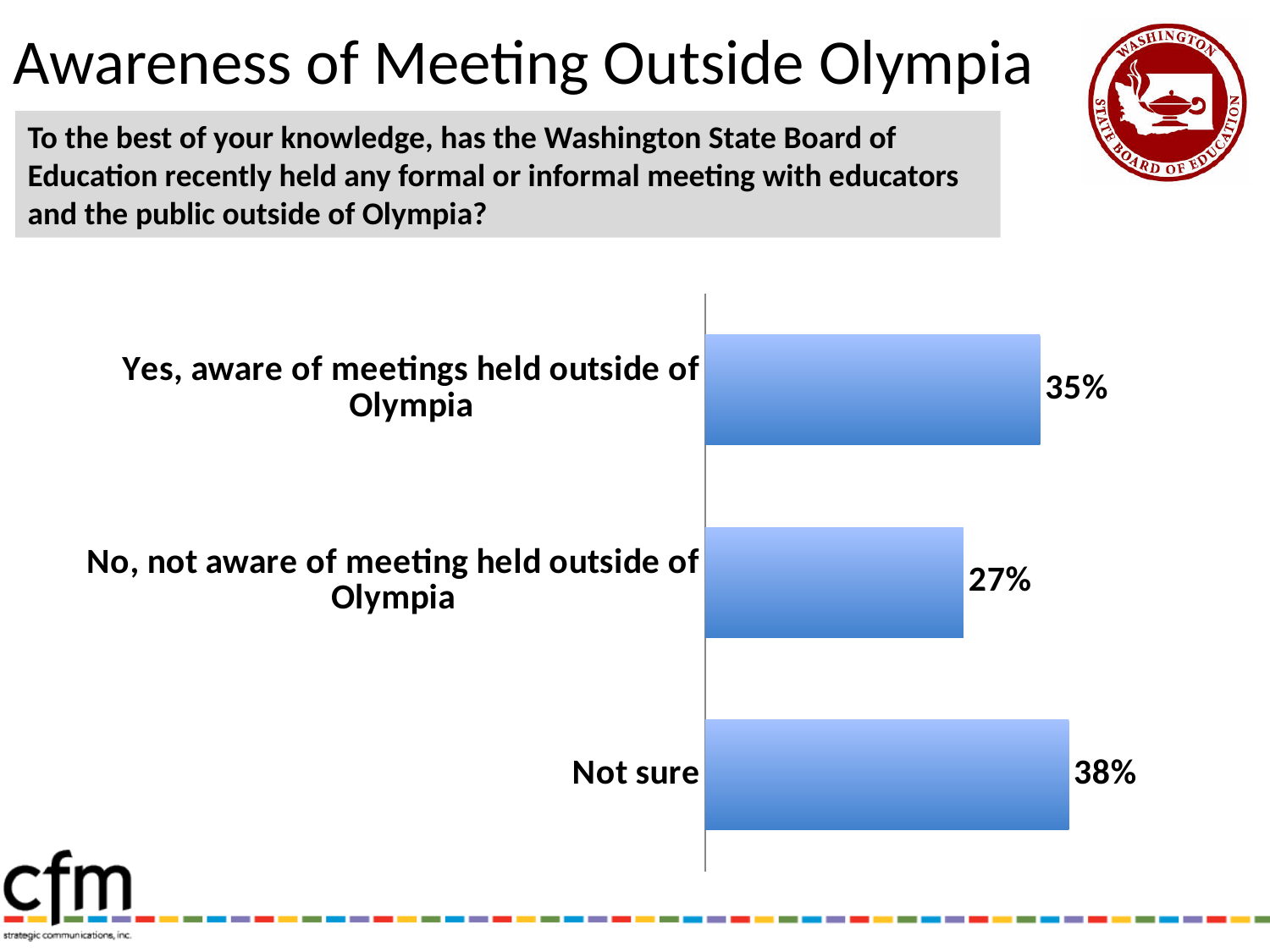
Which is larger: the percentage for "Yes, aware of meetings held outside of Olympia" or for "No, not aware of meeting held outside of Olympia"? Yes, aware of meetings held outside of Olympia Which response category has the highest percentage? Not sure Which response category has the lowest percentage? No, not aware of meeting held outside of Olympia What is the difference in percentage points between "Not sure" and "Yes, aware of meetings held outside of Olympia"? 3 percentage points What type of chart is shown on the slide? Bar chart How many response categories are shown in the chart? 3 What is the difference in percentage points between "Yes, aware of meetings held outside of Olympia" and "No, not aware of meeting held outside of Olympia"? 8 percentage points What percentage of respondents said they were not aware of meetings held outside of Olympia? 27% What is the title of the slide containing the chart? Awareness of Meeting Outside Olympia What colour are the bars in the chart? Blue What percentage of respondents answered "Not sure"? 38% What percentage of respondents said they were aware of meetings held outside of Olympia? 35%